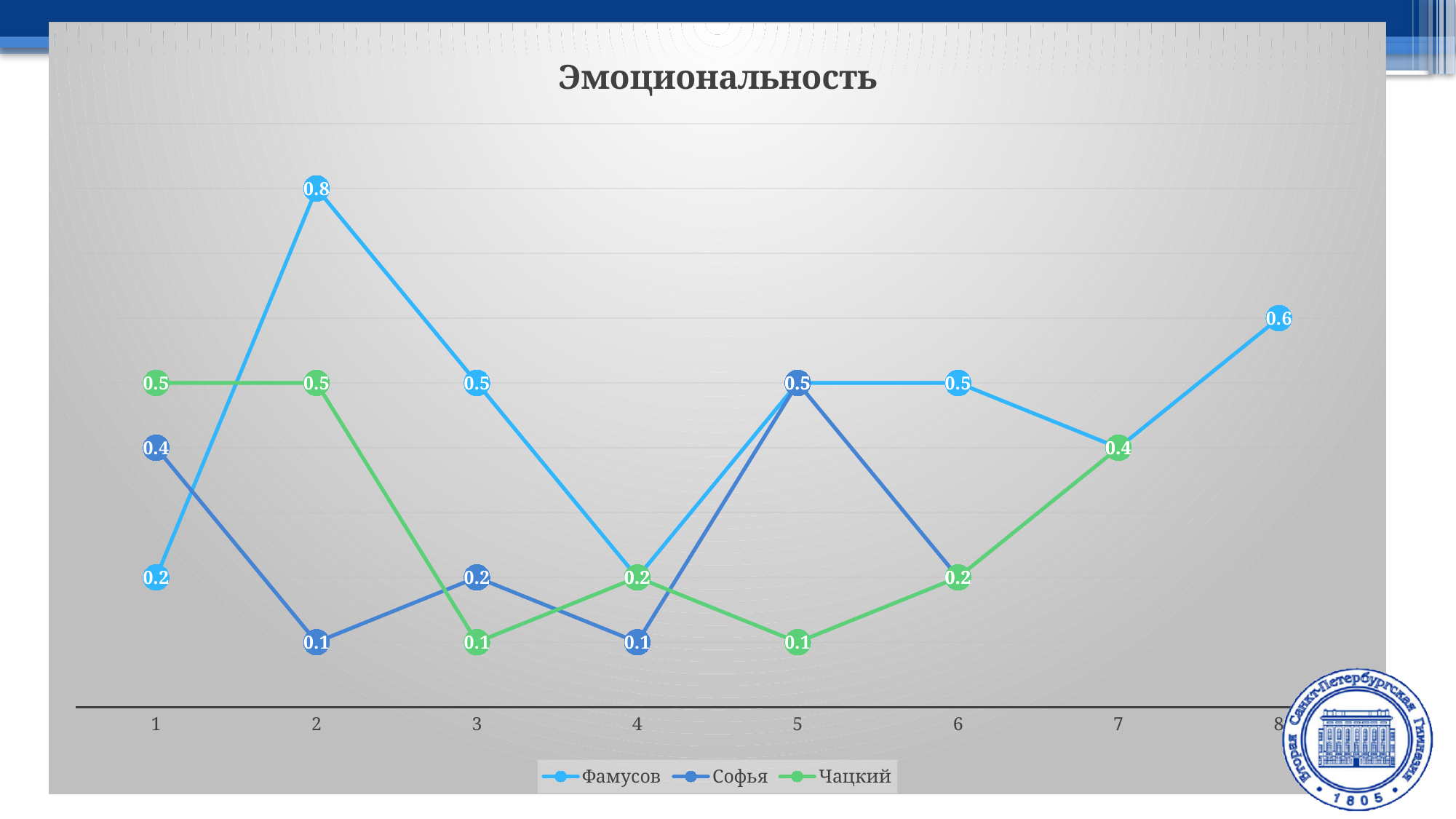
At which category does Фамусов reach its highest value? 2 How many categories are shown on the x axis? 8 What is the value for Фамусов at category 8? 0.6 Does the Фамусов line rise or fall from category 1 to category 2? rise What is the value for Чацкий at category 3? 0.1 What kind of chart is shown on the slide? line chart How many series does the legend list? 3 What is the title of the chart? Эмоциональность What is the difference between the Фамусов values at category 2 and category 1? 0.6 What is the value for Софья at category 1? 0.4 At category 1, which is larger: the value for Чацкий or the value for Фамусов? Чацкий What is the value for Фамусов at category 2? 0.8